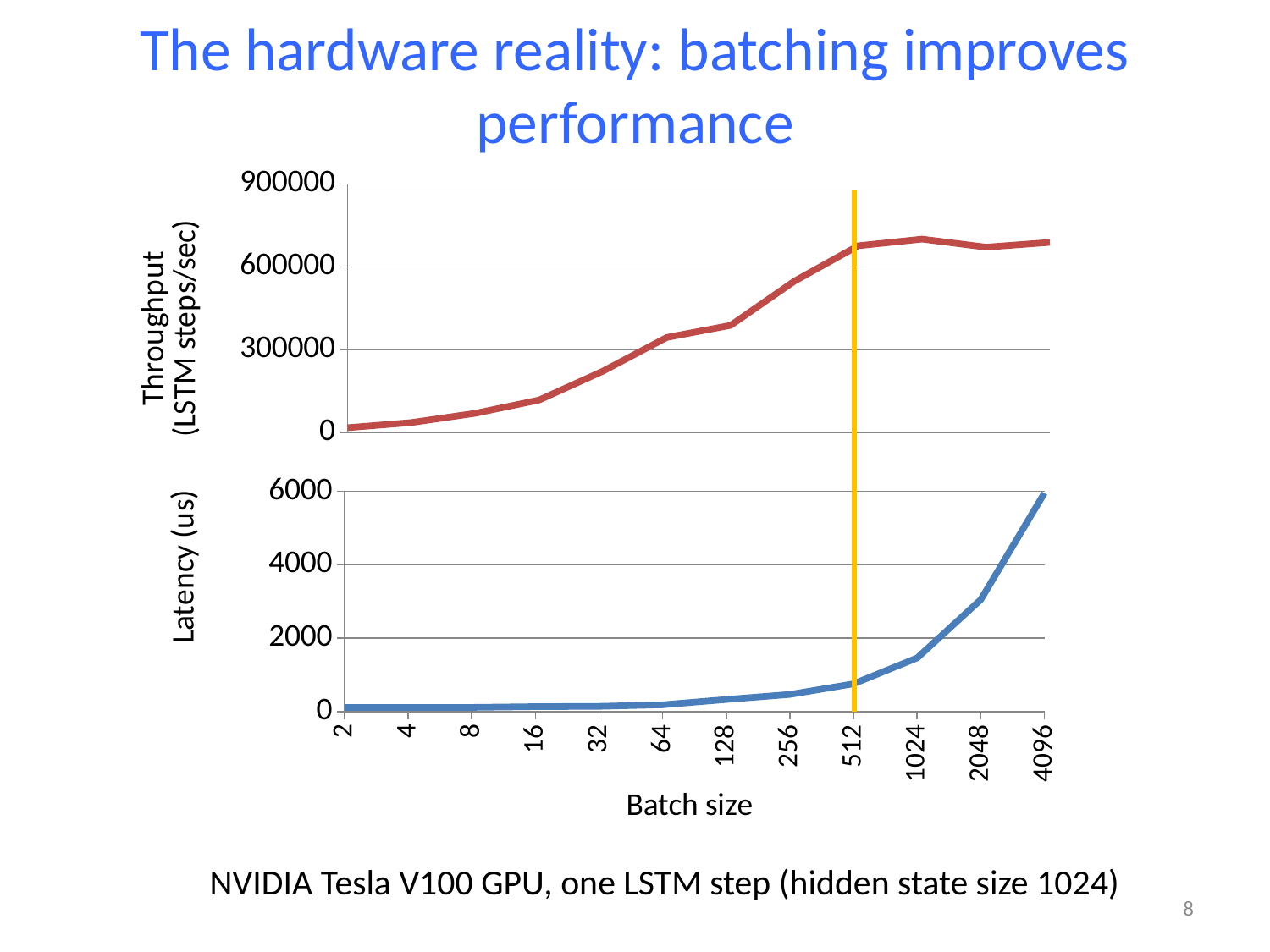
In the top chart (Throughput), which batch size has the lowest throughput? 2 In the top chart (Throughput), does throughput generally rise or fall as batch size increases from 2 to 512? rise In the bottom chart (Latency), is the latency at batch size 4096 greater or less than 4000? greater In the top chart (Throughput), is the throughput at batch size 16 greater or less than 300000? less What kind of chart is the top chart (Throughput) on the slide? line chart In the bottom chart (Latency), is the latency at batch size 512 greater or less than 2000? less In the bottom chart (Latency), does latency rise or fall as batch size increases from 512 to 4096? rise At which batch size is the vertical orange line drawn across both charts? 512 How many batch sizes are plotted along the x axis of the charts? 12 In the bottom chart (Latency), which batch size has the highest latency? 4096 What kind of chart is the bottom chart (Latency) on the slide? line chart